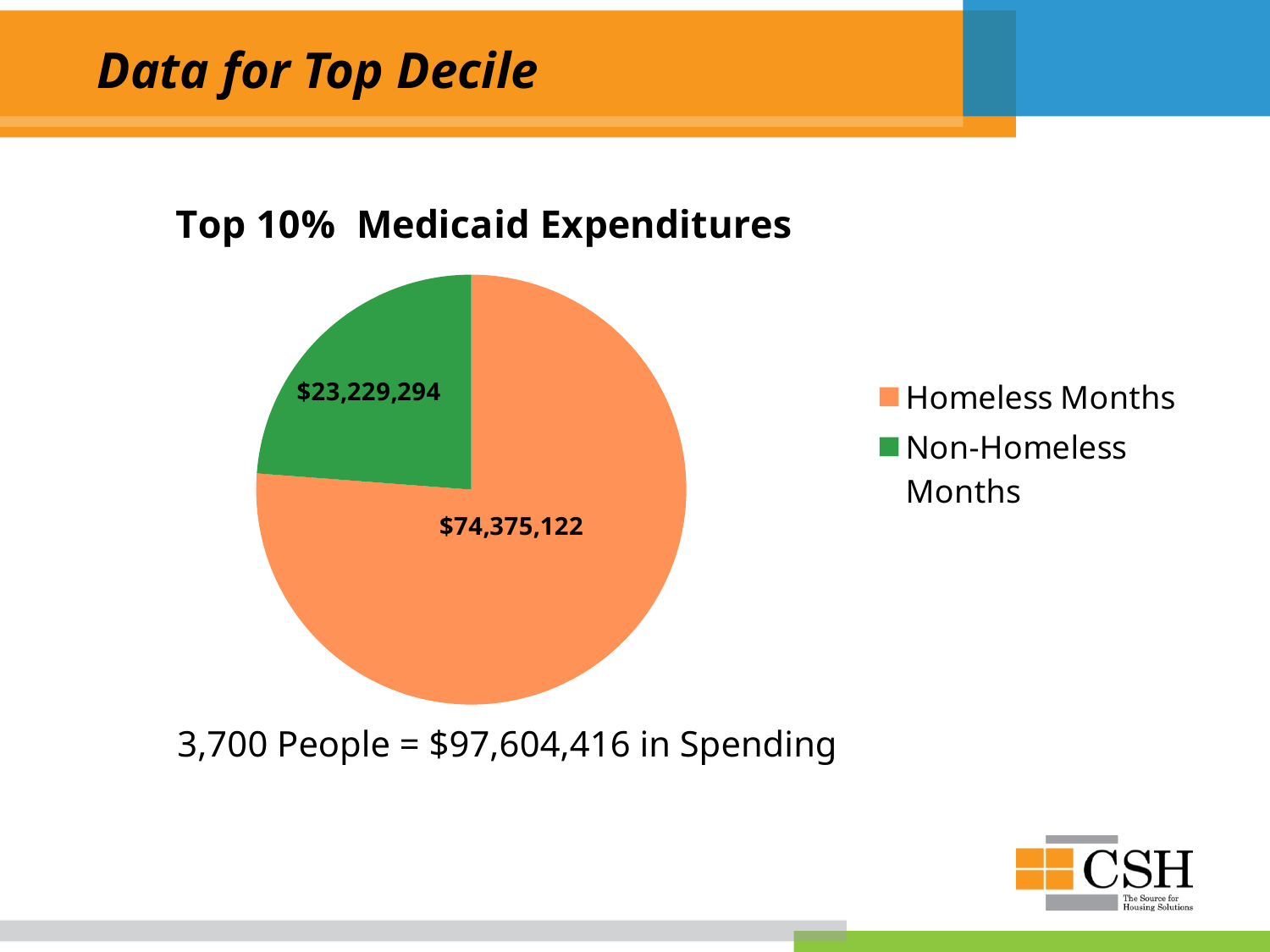
What type of chart is shown on the slide? Pie chart How many slices does the pie chart have? 2 How many entries does the legend list? 2 Which is larger, Homeless Months or Non-Homeless Months? Homeless Months What is the title of the chart? Top 10% Medicaid Expenditures What is the total of the two slices in the pie chart? $97,604,416 Which category has the largest slice of the pie? Homeless Months What is the value for Non-Homeless Months? $23,229,294 What is the value for Homeless Months? $74,375,122 What is the difference between Homeless Months and Non-Homeless Months expenditures? $51,145,828 Which category has the smallest slice of the pie? Non-Homeless Months